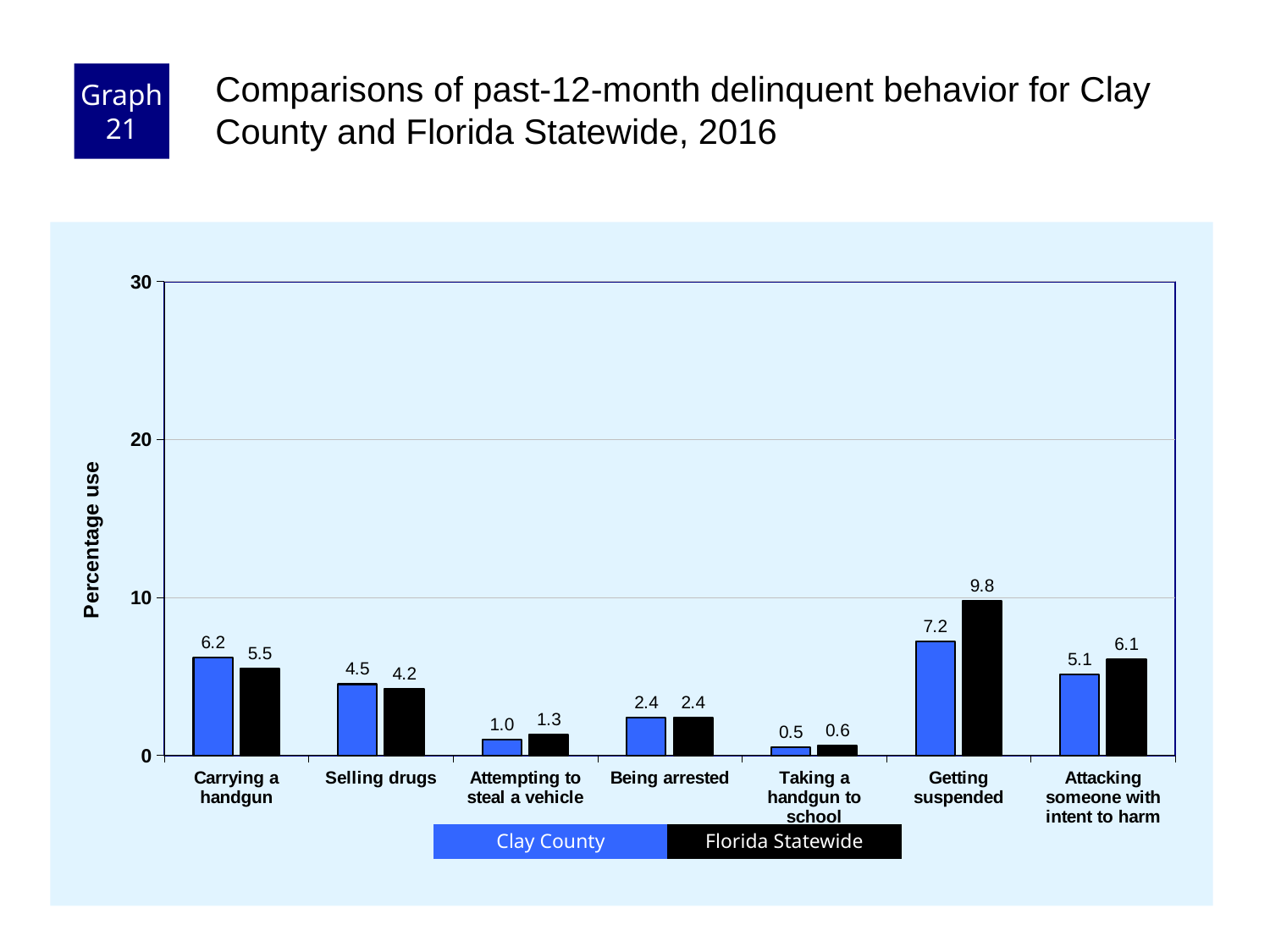
What is the Florida Statewide value for Carrying a handgun? 5.5 What is the Clay County value for Taking a handgun to school? 0.5 What is the label of the y axis? Percentage use How many behavior categories are shown on the x axis? 7 Which category has the highest Florida Statewide value? Getting suspended How many series does the legend list? 2 Which category has the lowest Clay County value? Taking a handgun to school Is the Florida Statewide value for Getting suspended greater or less than 10? less What kind of chart is shown on the slide? bar chart What is the Clay County value for Getting suspended? 7.2 Which is larger for Selling drugs, the Clay County value or the Florida Statewide value? Clay County What is the difference between the Florida Statewide and Clay County values for Getting suspended? 2.6